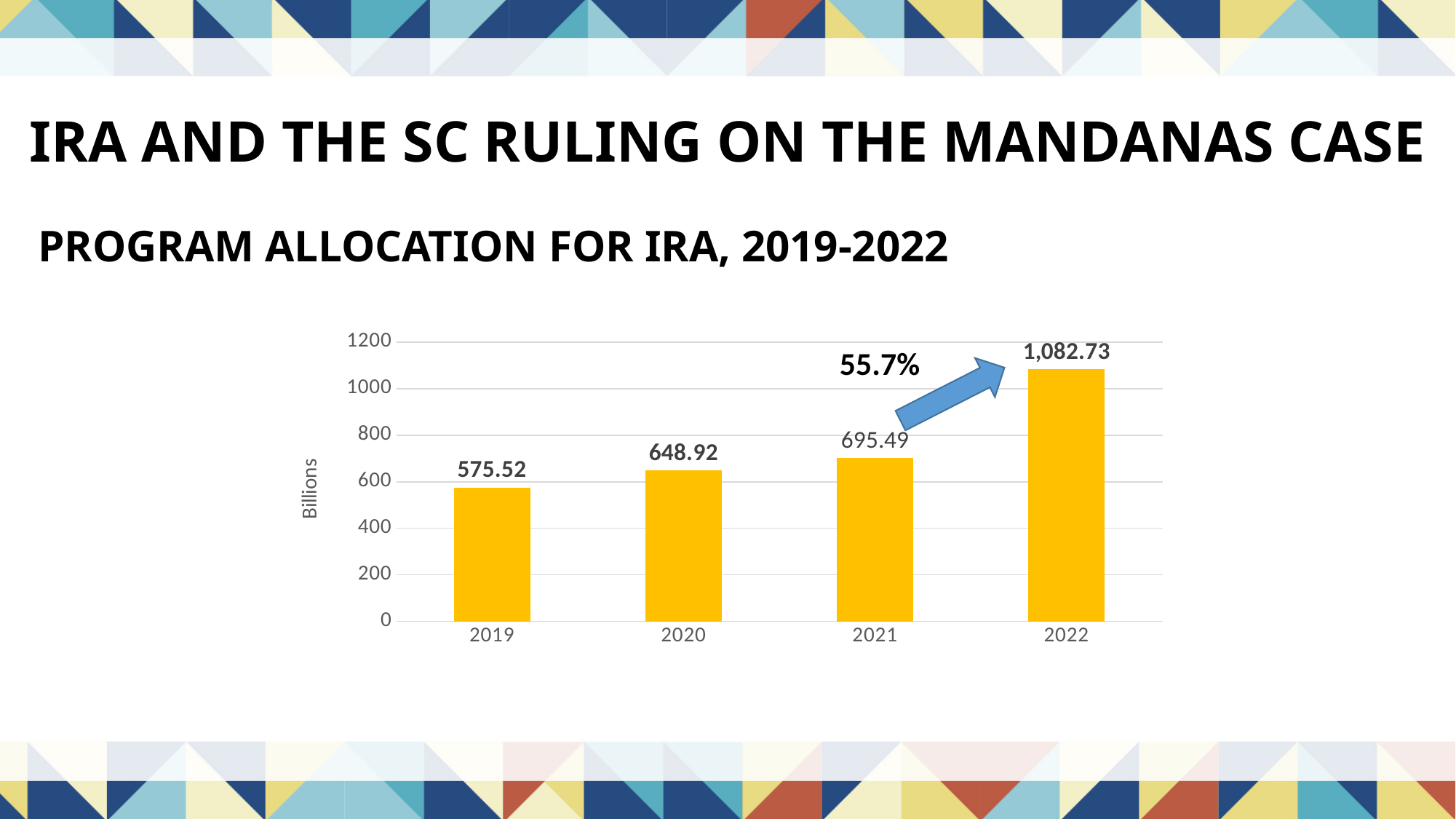
Which is larger, the program allocation for 2020 or for 2021? 2021 Do the program allocation values rise or fall from 2019 to 2022? rise What is the difference between the 2020 and 2019 program allocations for IRA? 73.40 What is the program allocation for IRA in 2022? 1,082.73 Is the program allocation for 2022 greater or less than 1000? greater How many years are shown on the chart? 4 What is the program allocation for IRA in 2021? 695.49 What is the program allocation for IRA in 2019? 575.52 What is the difference between the 2022 and 2021 program allocations for IRA? 387.24 Which year has the lowest program allocation for IRA? 2019 What kind of chart is used to show the program allocation for IRA? bar chart Which year has the highest program allocation for IRA? 2022